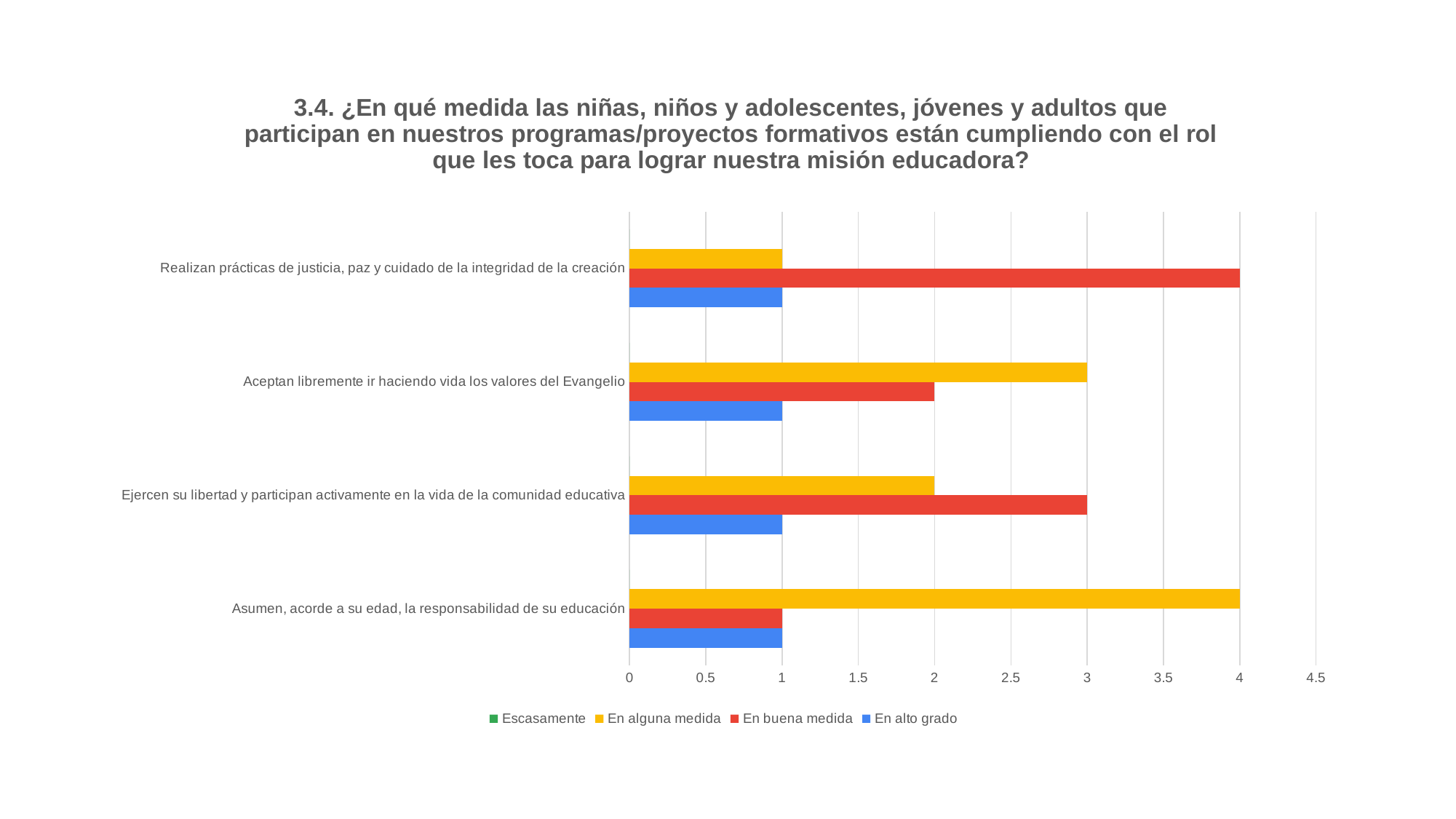
Which category has the highest value for 'En alguna medida'? Asumen, acorde a su edad, la responsabilidad de su educación How many categories are plotted on the chart? 4 What is the value of 'En alguna medida' for 'Asumen, acorde a su edad, la responsabilidad de su educación'? 4 For 'Aceptan libremente ir haciendo vida los valores del Evangelio', which is larger: 'En alguna medida' or 'En buena medida'? En alguna medida Which legend entry is shown in green? Escasamente What is the difference between 'En buena medida' and 'En alto grado' for 'Realizan prácticas de justicia, paz y cuidado de la integridad de la creación'? 3 What kind of chart is shown on the slide? bar chart What is the value of 'En buena medida' for 'Realizan prácticas de justicia, paz y cuidado de la integridad de la creación'? 4 Which category has the lowest value for 'En buena medida'? Asumen, acorde a su edad, la responsabilidad de su educación How many series does the legend list? 4 What is the value of 'En buena medida' for 'Ejercen su libertad y participan activamente en la vida de la comunidad educativa'? 3 What is the value of 'En alguna medida' for 'Aceptan libremente ir haciendo vida los valores del Evangelio'? 3